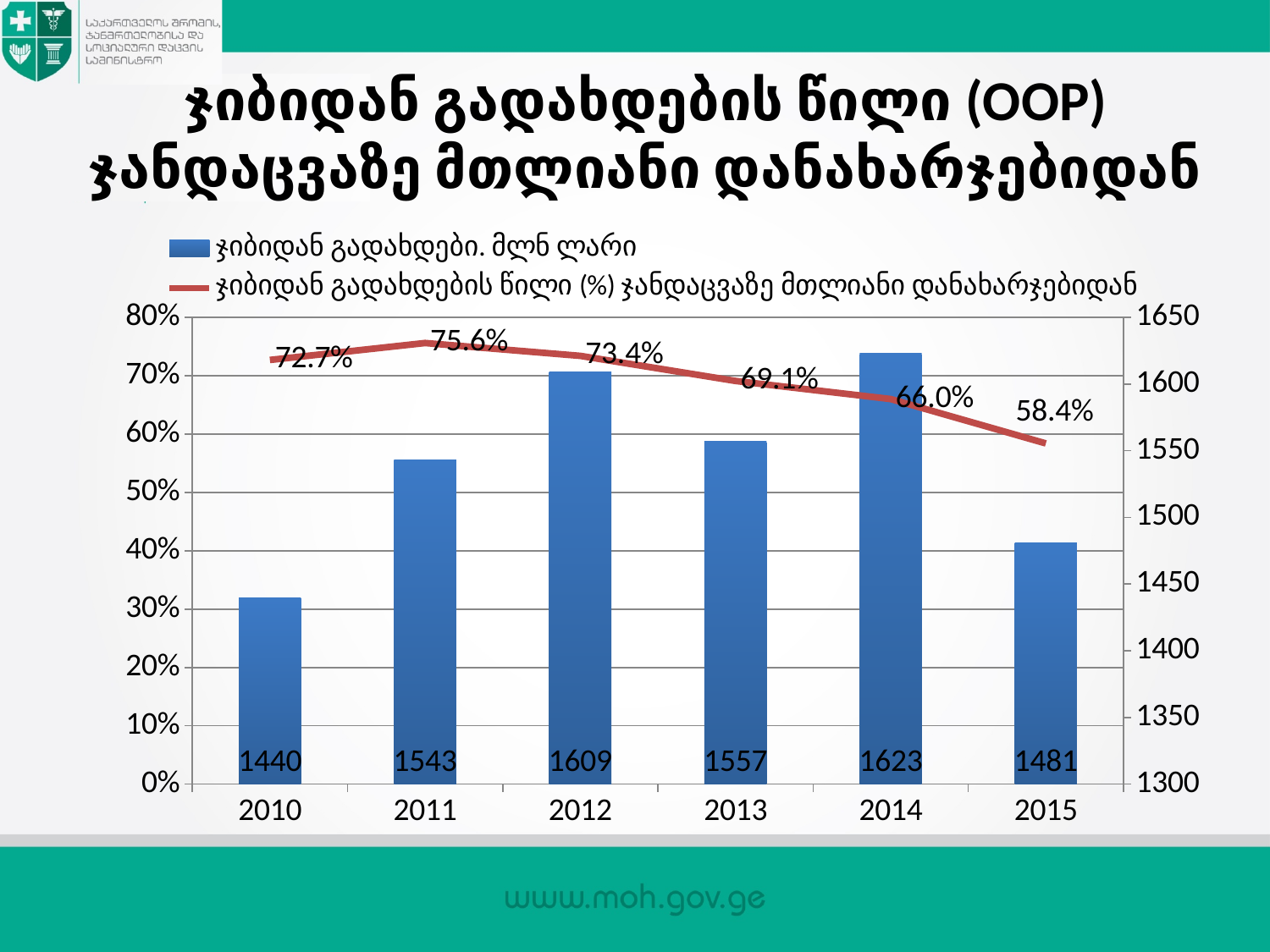
Which year has the lowest out-of-pocket share (%) on the line? 2015 Which year has higher out-of-pocket payments (bars), 2013 or 2015? 2013 How many years are shown on the x axis? 6 What is the out-of-pocket share (%) shown for 2011? 75.6% What is the difference between the out-of-pocket share in 2011 and 2015? 17.2% Which year has the highest out-of-pocket payments (bars)? 2014 Does the out-of-pocket share (%) line rise or fall from 2011 to 2015? fall How many series does the legend list? 2 What is the value of out-of-pocket payments (million GEL, bars) for 2012? 1609 What is the out-of-pocket share (%) of total health expenditure shown for 2015? 58.4% Which year has the lowest out-of-pocket payments (bars)? 2010 What is the difference between out-of-pocket payments in 2014 and 2010 (bars)? 183